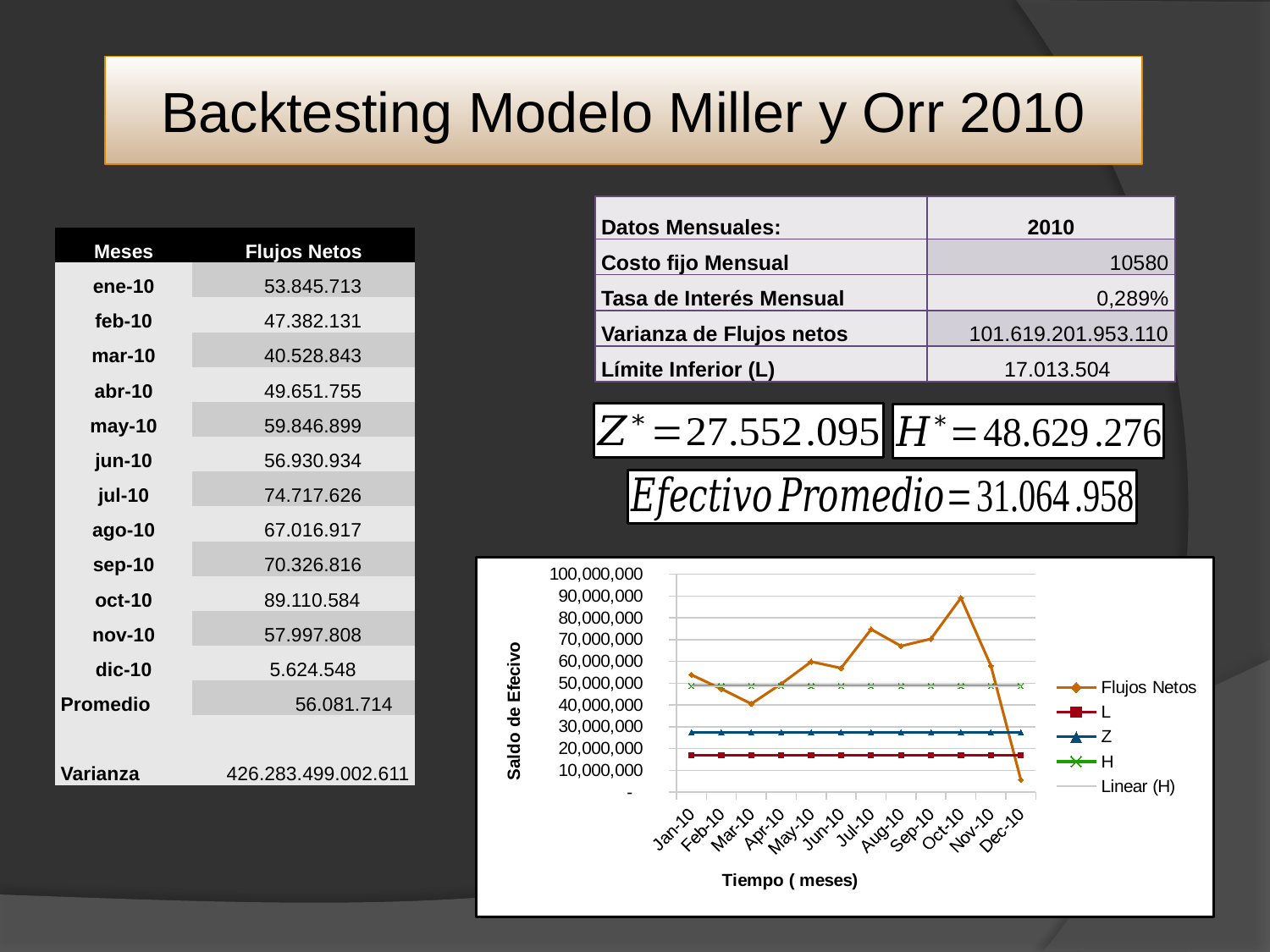
Is the Flujos Netos value for Dec-10 greater or less than 10,000,000? less What kind of chart is shown on the slide? line chart In which month does the Flujos Netos series reach its highest value? Oct-10 Is the Flujos Netos value for Jul-10 greater or less than 70,000,000? greater How many months are plotted along the x axis of the chart? 12 Which month has the larger Flujos Netos value, Jul-10 or Aug-10? Jul-10 How many series does the chart legend list? 5 Does the Flujos Netos series rise or fall from Oct-10 to Dec-10? fall What is the title of the chart's y axis? Saldo de Efecivo Is the Flujos Netos value for Oct-10 greater or less than 80,000,000? greater In which month does the Flujos Netos series reach its lowest value? Dec-10